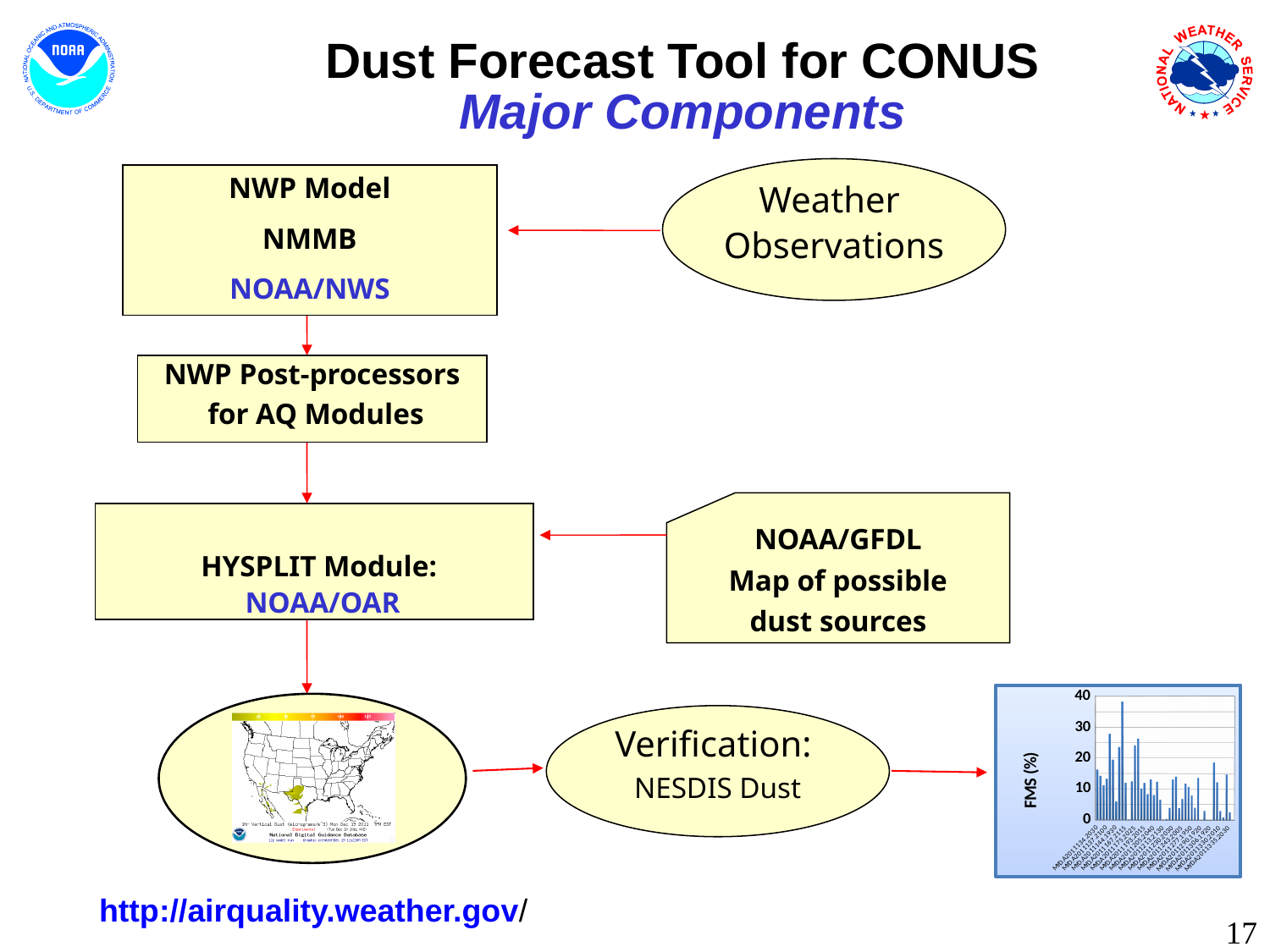
In the bar chart in the bottom-right corner, is the value of the tallest bar greater or less than 30? greater What is the label on the vertical axis of the bar chart in the bottom-right corner? FMS (%) What kind of chart is shown in the bottom-right corner of the slide? bar chart What is the highest tick value shown on the vertical axis of the bar chart in the bottom-right corner? 40 In the bar chart in the bottom-right corner, is the value of the tallest bar greater or less than 40? less